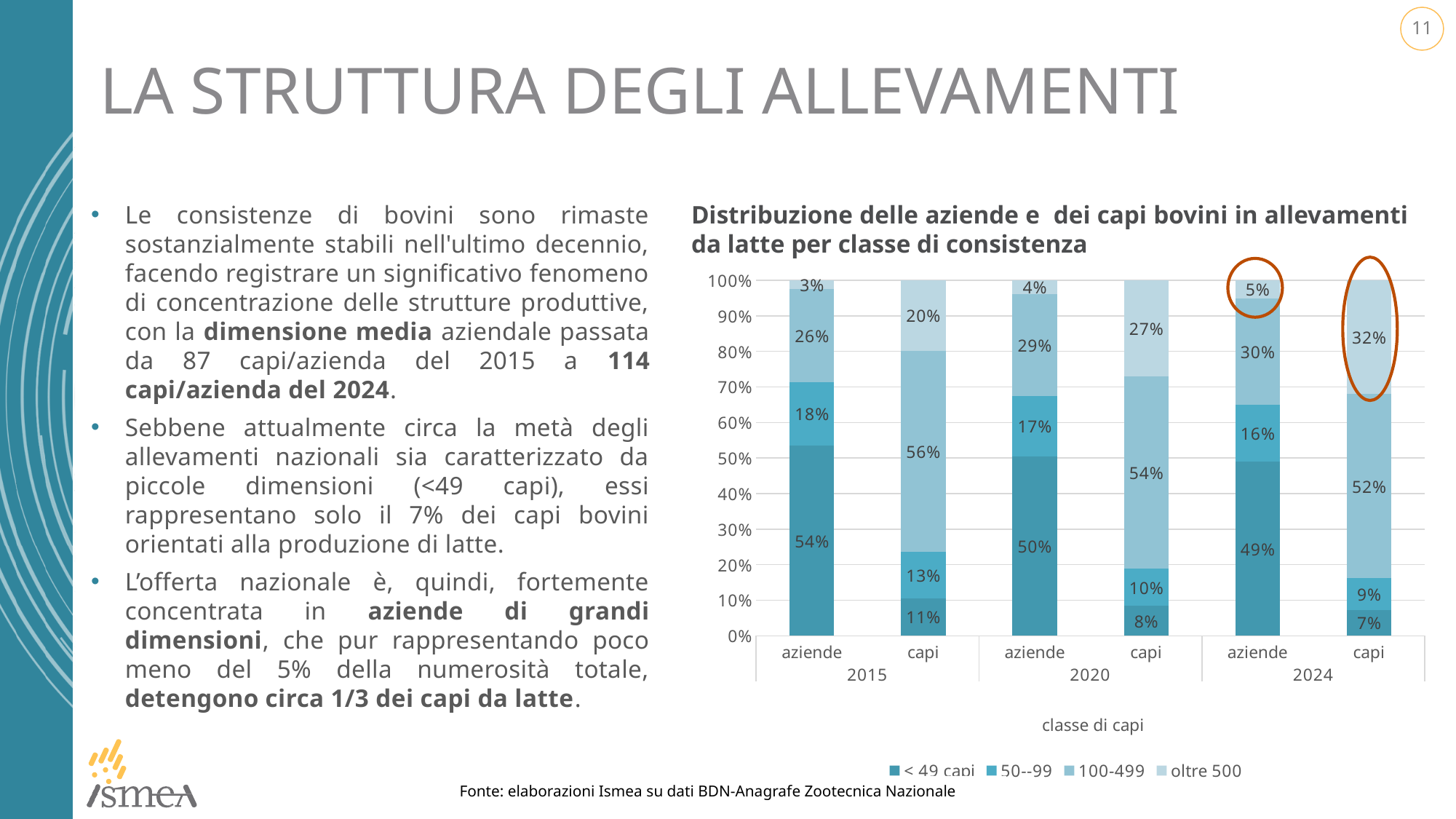
What is the value of the '50-99' segment for 'aziende' in 2024? 16% What is the value of the 'oltre 500' segment for 'capi' in 2024? 32% How many bars are plotted in the chart? 6 What kind of chart is shown on the slide? stacked bar chart In which year is the 'oltre 500' share of 'capi' the highest? 2024 In which year is the '< 49 capi' share of 'capi' the lowest? 2024 What is the value of the '< 49 capi' segment for 'aziende' in 2015? 54% What is the value of the '100-499' segment for 'capi' in 2020? 54% Which is larger: the '< 49 capi' share of 'aziende' in 2015 or in 2024? 2015 How many series does the legend list? 4 What is the difference between the 'oltre 500' share of 'capi' in 2024 and in 2015? 12% Does the 'oltre 500' share of 'aziende' rise or fall from 2015 to 2024? rise